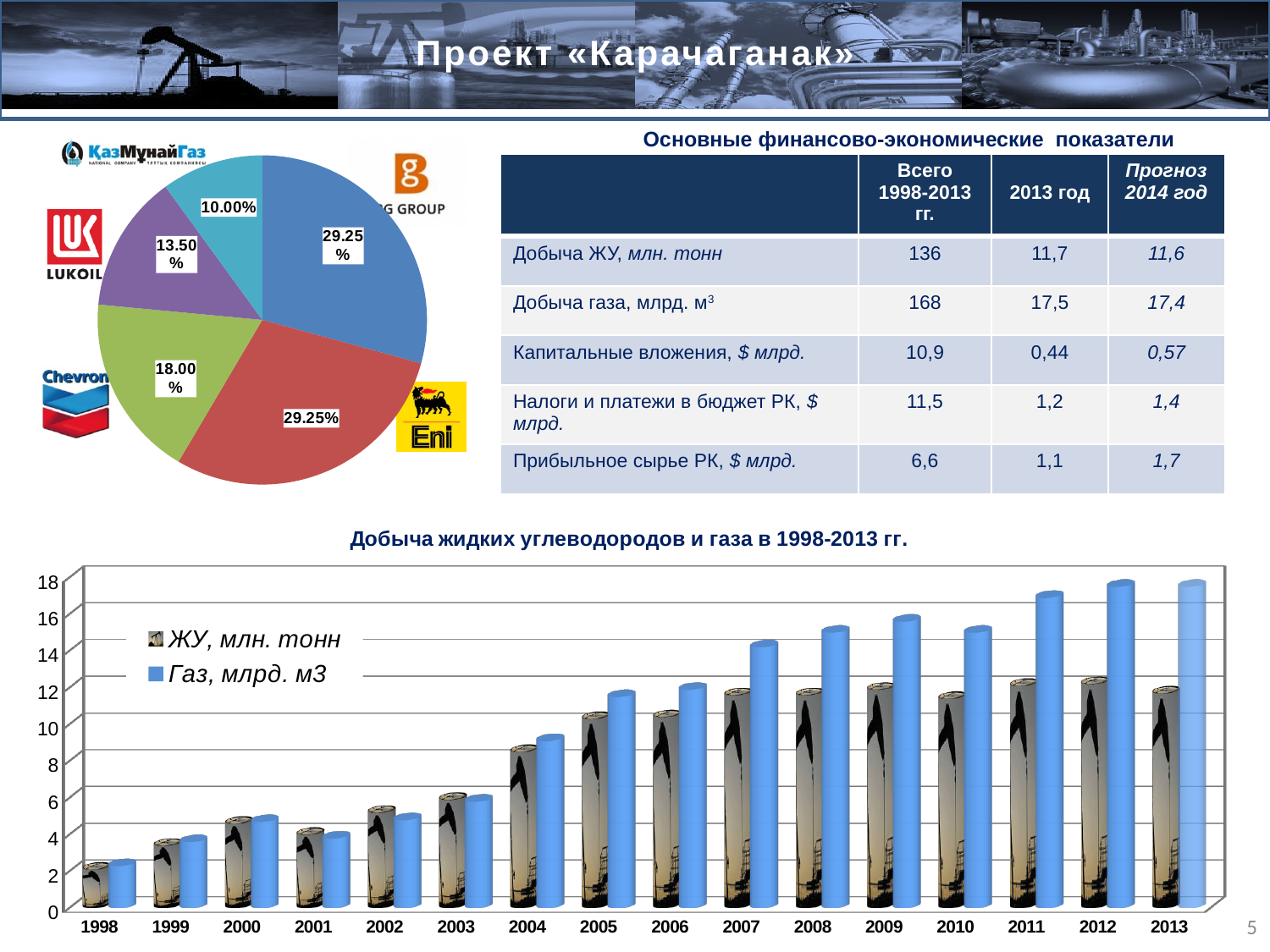
How many years are shown on the x axis of 'Добыча жидких углеводородов и газа в 1998-2013 гг.'? 16 In the pie chart on the upper left, what is the value of the purple slice? 13.50% In 'Добыча жидких углеводородов и газа в 1998-2013 гг.', is the value for 'Газ, млрд. м3' in 2013 greater or less than 16? greater How many slices does the pie chart on the upper left have? 5 In 'Добыча жидких углеводородов и газа в 1998-2013 гг.', which year has the lowest value for 'Газ, млрд. м3'? 1998 In the pie chart on the upper left, what is the difference between the green slice (18.00%) and the purple slice (13.50%)? 4.50% In the pie chart on the upper left, what is the value of the green slice? 18.00% In the pie chart on the upper left, what is the value of the smallest slice? 10.00% In 'Добыча жидких углеводородов и газа в 1998-2013 гг.', do the values for 'Газ, млрд. м3' generally rise or fall from 1998 to 2013? Rise What kind of chart is the chart on the upper left of the slide? Pie chart What kind of chart is 'Добыча жидких углеводородов и газа в 1998-2013 гг.'? Bar chart How many series does the legend of 'Добыча жидких углеводородов и газа в 1998-2013 гг.' list? 2